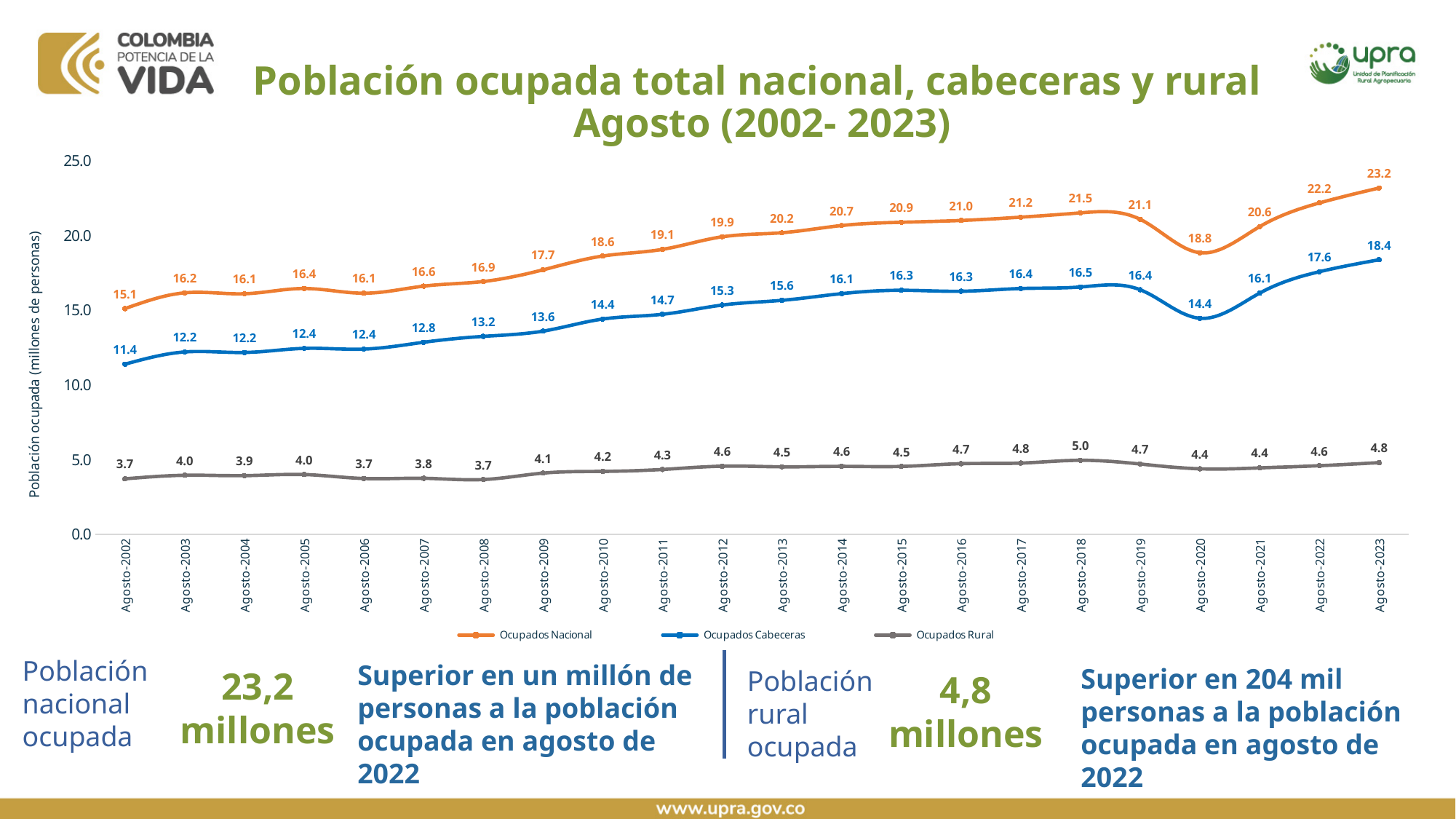
In which year is the Ocupados Nacional series at its lowest value? Agosto-2002 What is the value of Ocupados Nacional for Agosto-2023? 23.2 What is the value of Ocupados Cabeceras for Agosto-2020? 14.4 What is the difference between Ocupados Nacional in Agosto-2023 and Agosto-2022? 1.0 What is the y-axis label of the chart? Población ocupada (millones de personas) What kind of chart is shown on the slide? line chart Which is larger: Ocupados Cabeceras in Agosto-2019 or in Agosto-2020? Agosto-2019 How many series does the legend list? 3 In which year does the Ocupados Rural series reach its highest value? Agosto-2018 Is the value of Ocupados Nacional for Agosto-2020 greater or less than 20.0? less What is the value of Ocupados Rural for Agosto-2002? 3.7 How many years (data points) are plotted on the x axis? 22